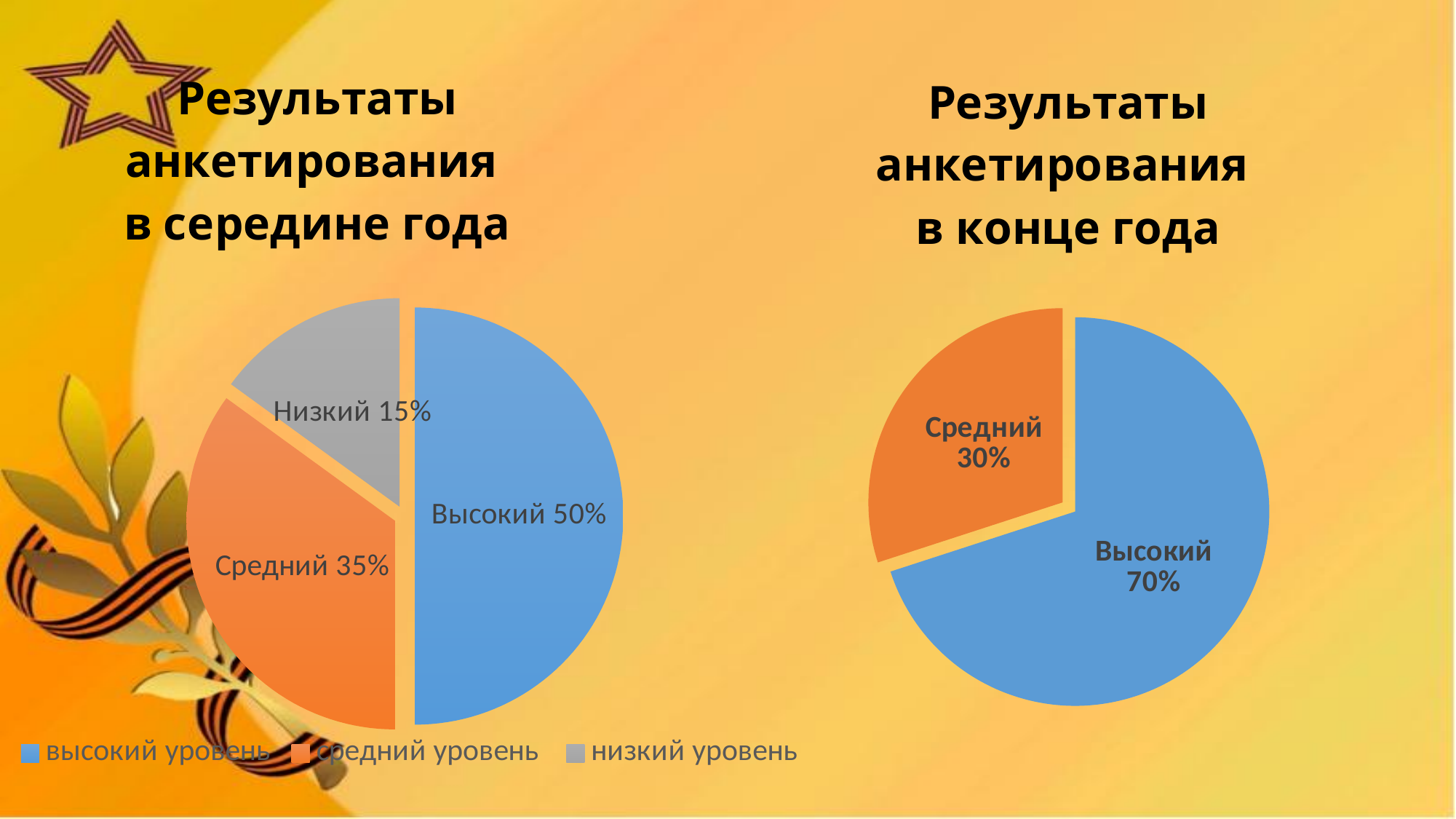
In the chart titled "Результаты анкетирования в середине года", what is the value for Высокий? 50% How many entries does the legend below the left chart list? 3 In the chart titled "Результаты анкетирования в конце года", what is the value for Средний? 30% In the chart titled "Результаты анкетирования в конце года", what is the difference between Высокий and Средний? 40% In the chart titled "Результаты анкетирования в середине года", which category has the largest slice? Высокий In the chart titled "Результаты анкетирования в середине года", which category has the smallest slice? Низкий What type of chart is the chart titled "Результаты анкетирования в середине года"? Pie chart In the chart titled "Результаты анкетирования в середине года", which is larger, Средний or Низкий? Средний How many slices does the chart titled "Результаты анкетирования в конце года" have? 2 In the chart titled "Результаты анкетирования в середине года", what is the difference between Средний and Низкий? 20% In the chart titled "Результаты анкетирования в середине года", what is the value for Низкий? 15% In the chart titled "Результаты анкетирования в конце года", what is the value for Высокий? 70%